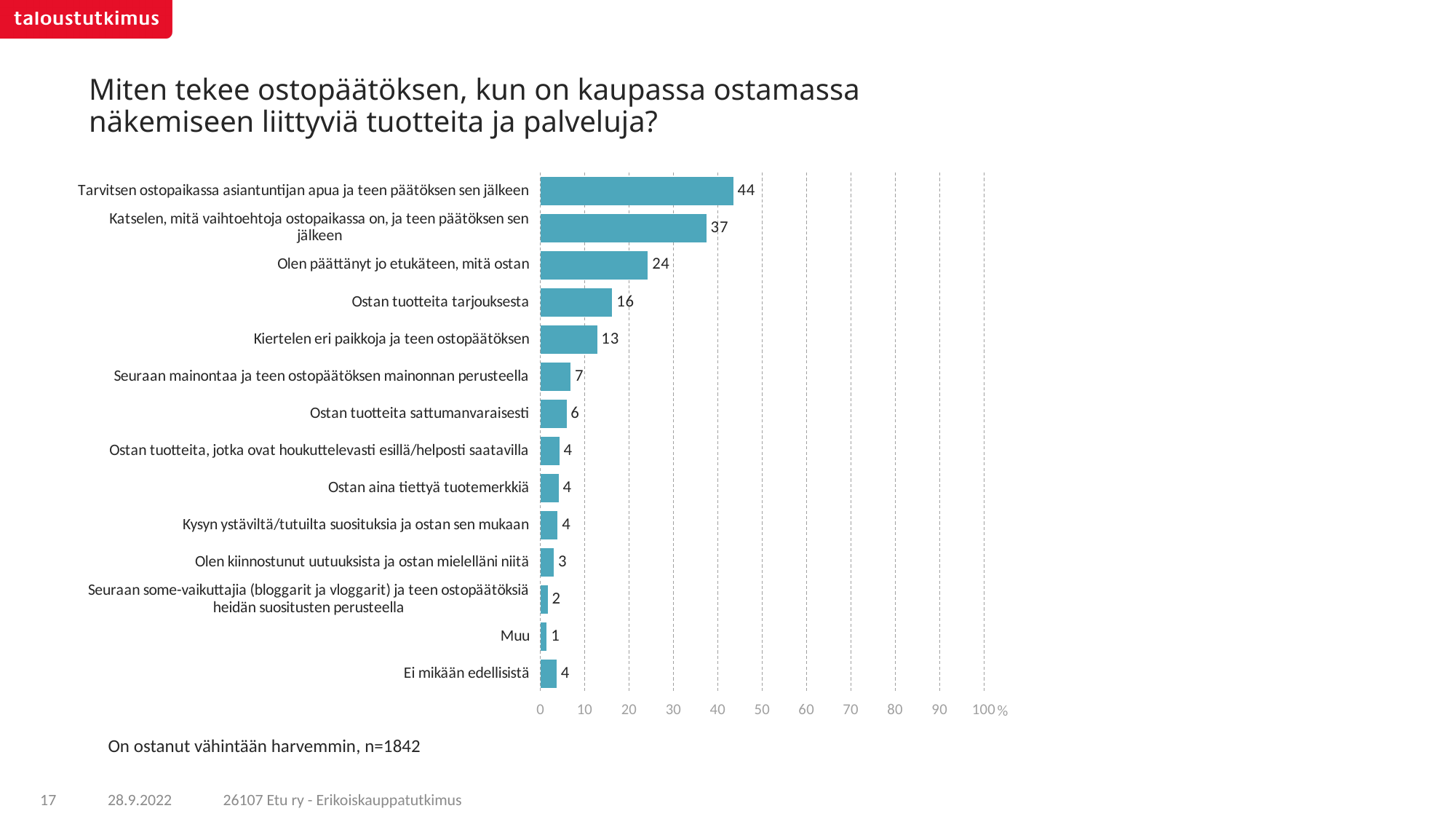
What kind of chart is shown on the slide? Bar chart How many categories are shown in the chart? 14 What is the value for "Kiertelen eri paikkoja ja teen ostopäätöksen"? 13 What is the difference between the values for "Ostan tuotteita tarjouksesta" and "Seuraan mainontaa ja teen ostopäätöksen mainonnan perusteella"? 9 What is the value for "Tarvitsen ostopaikassa asiantuntijan apua ja teen päätöksen sen jälkeen"? 44 What is the difference between the values for "Tarvitsen ostopaikassa asiantuntijan apua ja teen päätöksen sen jälkeen" and "Katselen, mitä vaihtoehtoja ostopaikassa on, ja teen päätöksen sen jälkeen"? 7 What is the value for "Muu"? 1 Which is larger, the value for "Ostan tuotteita sattumanvaraisesti" or the value for "Olen kiinnostunut uutuuksista ja ostan mielelläni niitä"? Ostan tuotteita sattumanvaraisesti Is the value for "Olen päättänyt jo etukäteen, mitä ostan" greater or less than 20? greater Which category has the lowest value? Muu What is the value for "Olen päättänyt jo etukäteen, mitä ostan"? 24 Which category has the highest value? Tarvitsen ostopaikassa asiantuntijan apua ja teen päätöksen sen jälkeen